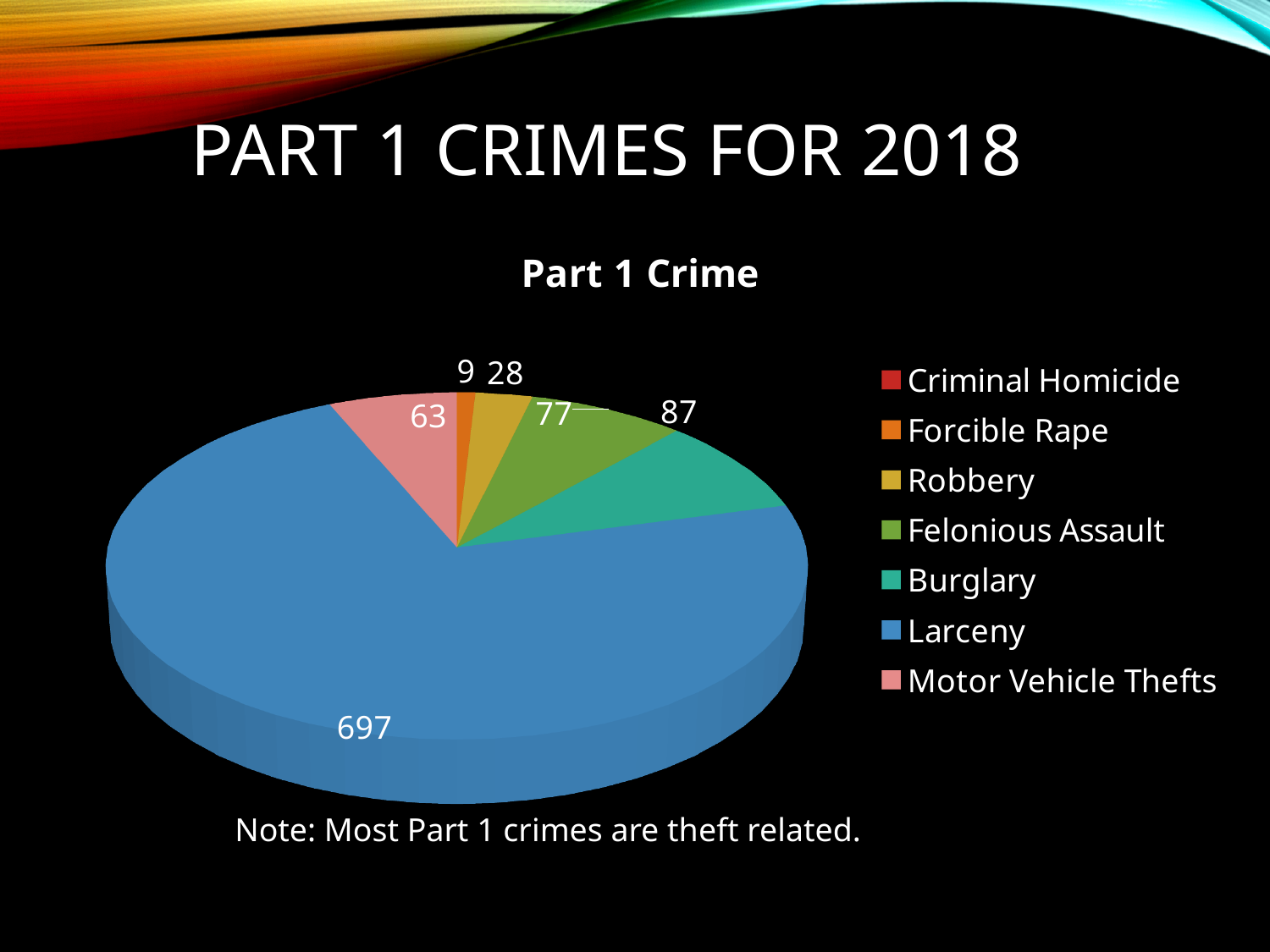
What is the value for Robbery in the Part 1 Crime chart? 28 What is the value for Motor Vehicle Thefts in the Part 1 Crime chart? 63 What is the value for Burglary in the Part 1 Crime chart? 87 What type of chart is shown on the slide? pie chart What is the value for Felonious Assault in the Part 1 Crime chart? 77 Which category has the largest slice in the Part 1 Crime chart? Larceny What is the value for Larceny in the Part 1 Crime chart? 697 What is the title of the chart on the slide? Part 1 Crime What is the value for Forcible Rape in the Part 1 Crime chart? 9 What is the difference between the values for Burglary and Felonious Assault? 10 Which is larger, the value for Burglary or the value for Felonious Assault? Burglary How many categories does the legend of the Part 1 Crime chart list? 7